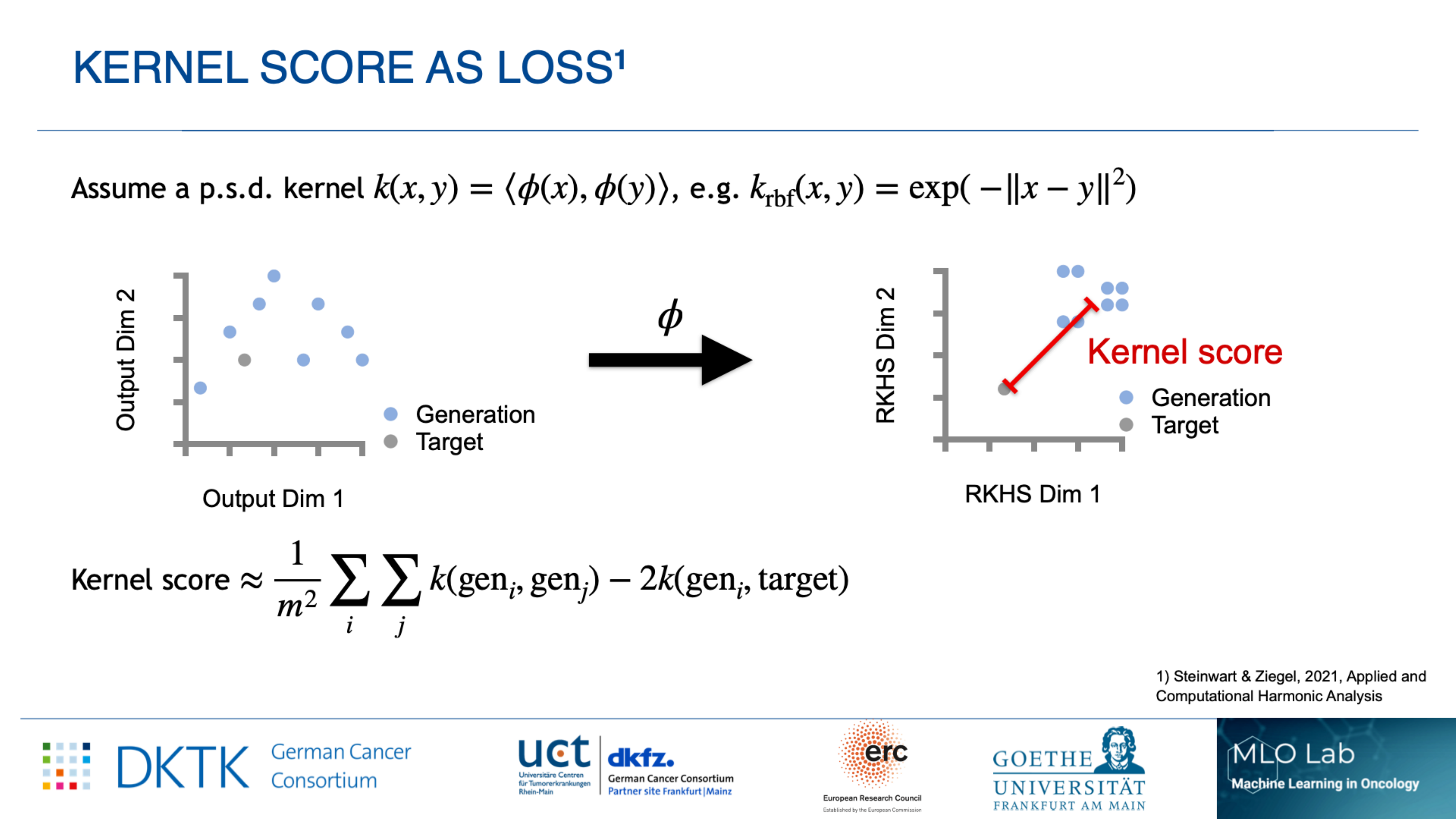
What is the x-axis label of the right chart? RKHS Dim 1 How many series does the legend of the left chart list? 2 In the left chart, how many Generation points are plotted? 8 How many series does the legend of the right chart list? 2 In the left chart, how many Target points are plotted? 1 What kind of chart is the left chart (Output Dim 1 vs Output Dim 2)? scatter plot In the left chart, which series has more plotted points, Generation or Target? Generation In the right chart, how many Target points are plotted? 1 What kind of chart is the right chart (RKHS Dim 1 vs RKHS Dim 2)? scatter plot What does the red line segment in the right chart represent? Kernel score